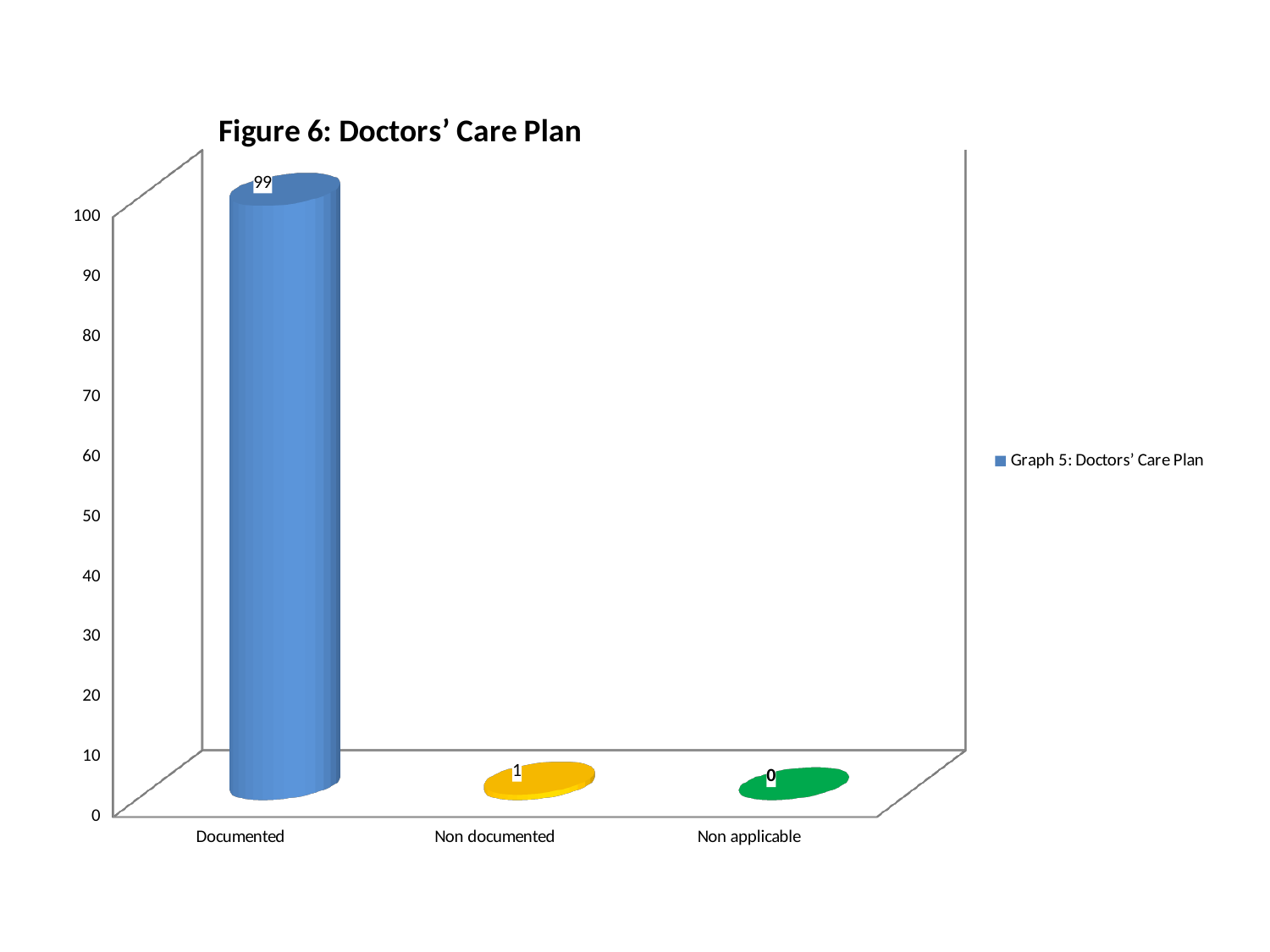
How many categories are shown on the x axis? 3 What is the value for Non documented? 1 What is the value for Documented? 99 What is the title of the chart? Figure 6: Doctors’ Care Plan Which category has the highest value? Documented What is the difference between the values for Documented and Non documented? 98 Which is larger, the value for Non documented or the value for Non applicable? Non documented What kind of chart is shown on the slide? bar chart Which category has the lowest value? Non applicable Is the value for Documented greater or less than 50? greater How many series does the legend list? 1 What is the value for Non applicable? 0